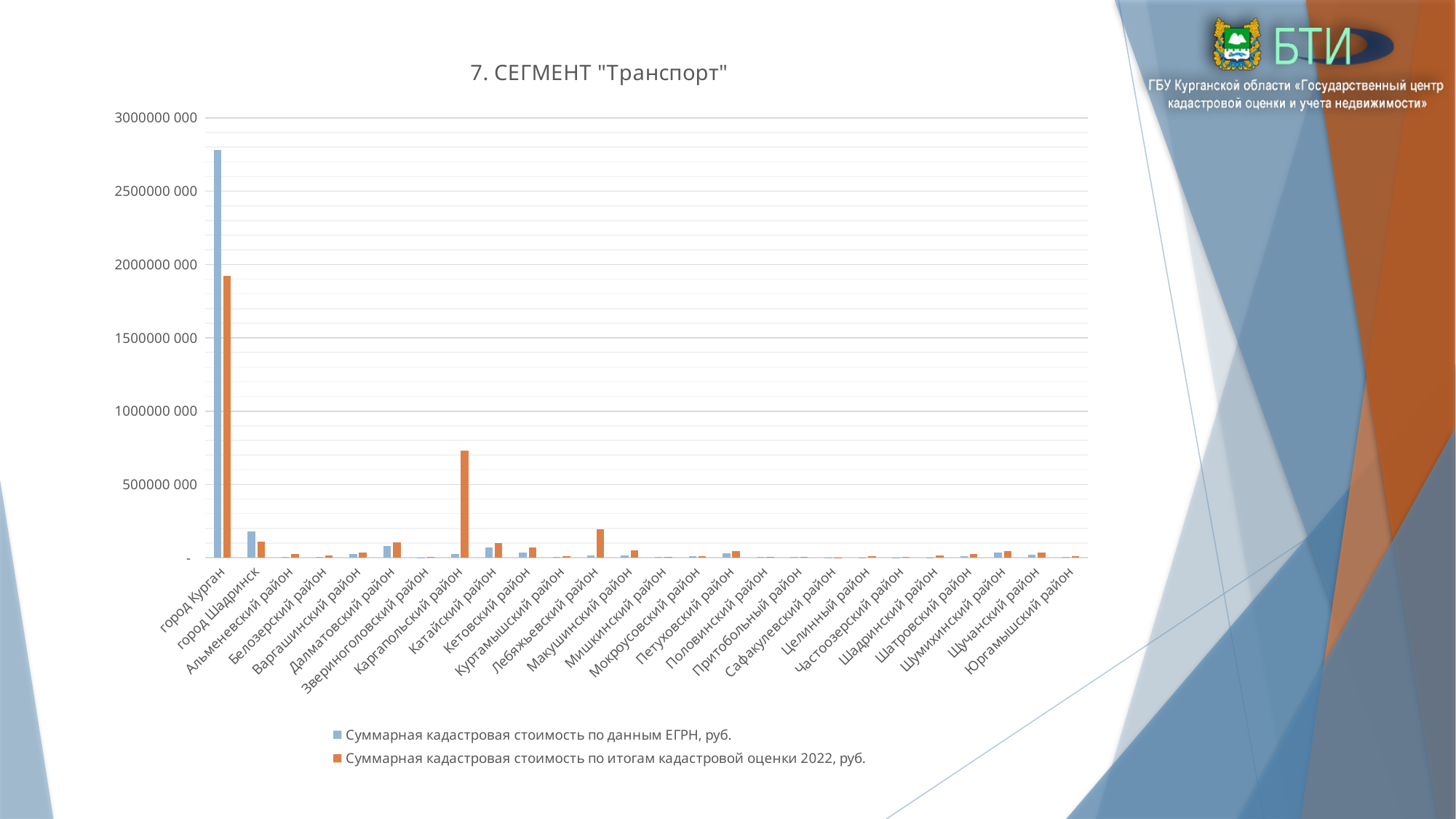
Is the value for город Курган in the series "Суммарная кадастровая стоимость по итогам кадастровой оценки 2022, руб." greater or less than 2000000 000? less What is the title of the chart? 7. СЕГМЕНТ "Транспорт" Which category has the highest value for the series "Суммарная кадастровая стоимость по данным ЕГРН, руб."? город Курган For Каргапольский район, which series has the larger value: "по данным ЕГРН" or "по итогам кадастровой оценки 2022"? Суммарная кадастровая стоимость по итогам кадастровой оценки 2022, руб. Which category has the highest value for the series "Суммарная кадастровая стоимость по итогам кадастровой оценки 2022, руб."? город Курган For город Курган, which series has the larger value: "по данным ЕГРН" or "по итогам кадастровой оценки 2022"? Суммарная кадастровая стоимость по данным ЕГРН, руб. How many categories are shown along the x axis? 26 Is the value for город Курган in the series "Суммарная кадастровая стоимость по данным ЕГРН, руб." greater or less than 2500000 000? greater What type of chart is shown on the slide? Bar chart Is the value for Каргапольский район in the series "Суммарная кадастровая стоимость по итогам кадастровой оценки 2022, руб." greater or less than 500000 000? greater How many series does the legend list? 2 Which colour represents the series "Суммарная кадастровая стоимость по итогам кадастровой оценки 2022, руб."? Orange